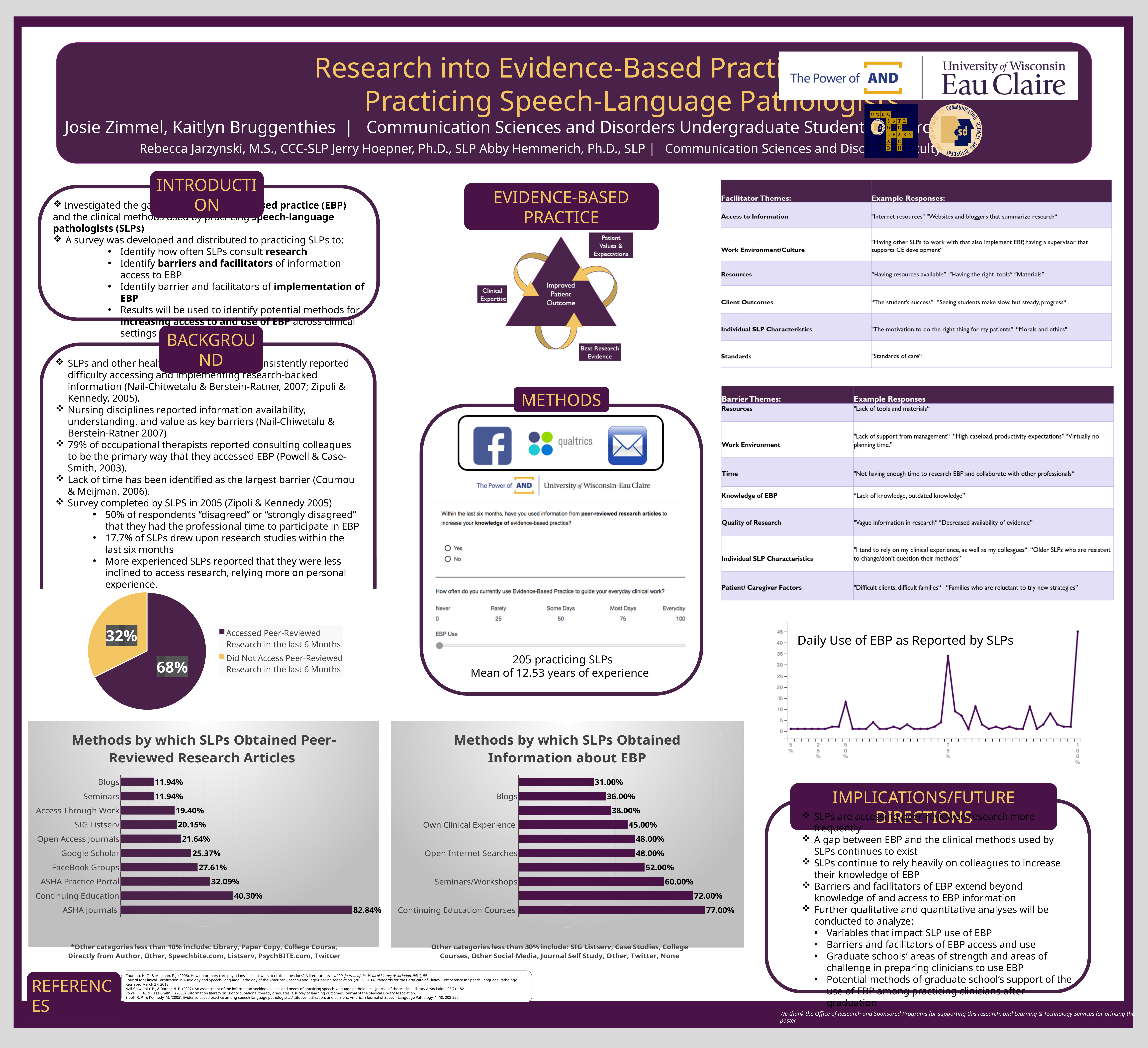
In the chart 'Methods by which SLPs Obtained Peer-Reviewed Research Articles', which category has the highest value? ASHA Journals In the chart 'Methods by which SLPs Obtained Information about EBP', what is the value for Seminars/Workshops? 60.00% In the chart 'Methods by which SLPs Obtained Peer-Reviewed Research Articles', what is the difference between Continuing Education and ASHA Practice Portal? 8.21% What kind of chart is 'Daily Use of EBP as Reported by SLPs'? line chart In the pie chart, what share of SLPs did not access peer-reviewed research in the last 6 months? 32% In the chart 'Methods by which SLPs Obtained Information about EBP', what is the value for Continuing Education Courses? 77.00% In the chart 'Methods by which SLPs Obtained Peer-Reviewed Research Articles', what is the value for Google Scholar? 25.37% In the chart 'Methods by which SLPs Obtained Peer-Reviewed Research Articles', how many categories are shown? 10 In the chart 'Methods by which SLPs Obtained Peer-Reviewed Research Articles', which is larger: FaceBook Groups or Open Access Journals? FaceBook Groups In the chart 'Methods by which SLPs Obtained Peer-Reviewed Research Articles', what is the value for ASHA Journals? 82.84% In the pie chart, what share of SLPs accessed peer-reviewed research in the last 6 months? 68% How many slices does the pie chart have? 2